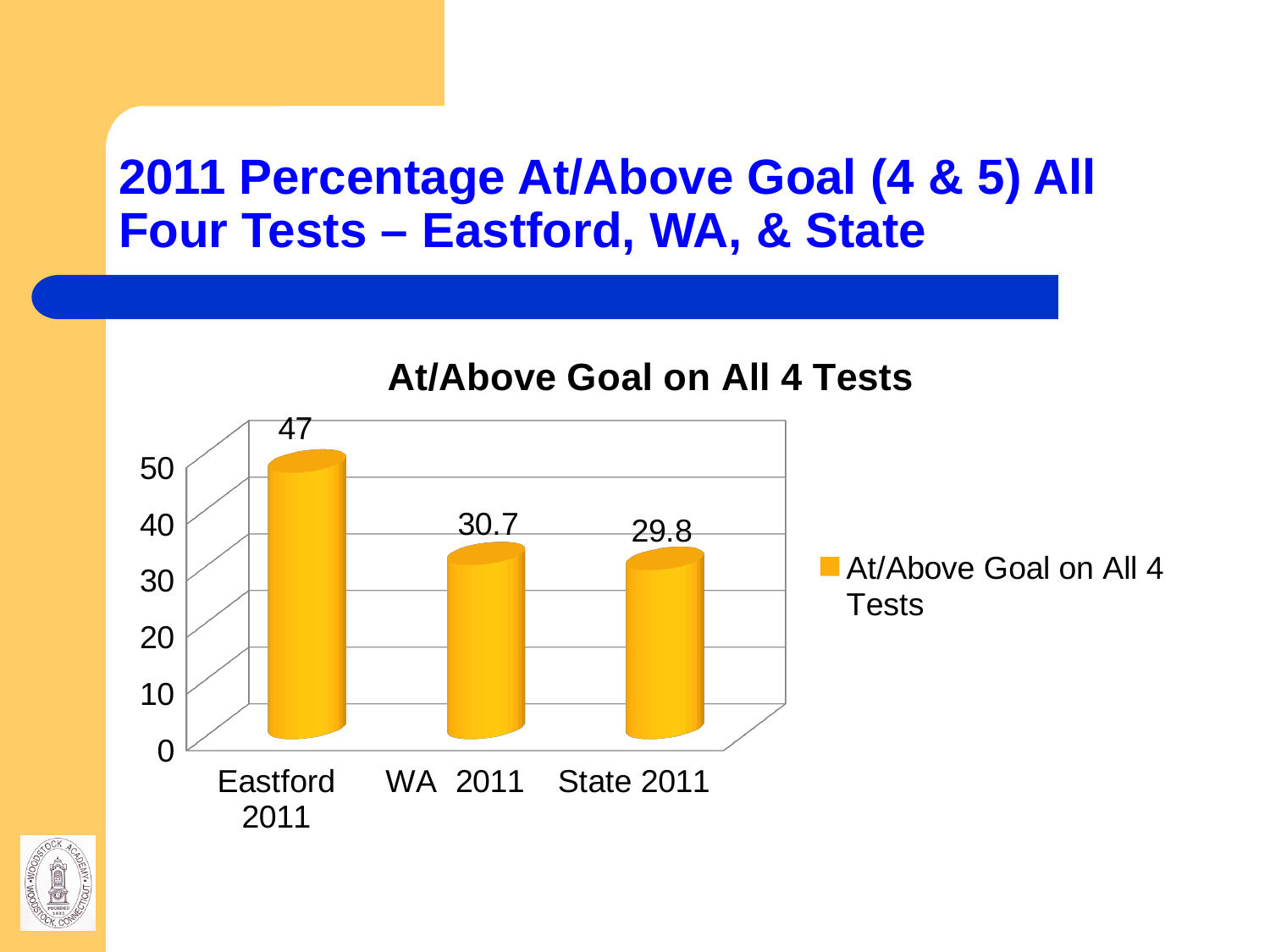
Is the value for Eastford 2011 greater or less than 40? greater How many categories are shown on the x axis? 3 What is the value for State 2011? 29.8 Which category has the lowest value? State 2011 What is the title of the chart? At/Above Goal on All 4 Tests What is the value for Eastford 2011? 47 Which category has the highest value? Eastford 2011 What kind of chart is shown? bar chart What is the difference between the values for WA 2011 and State 2011? 0.9 Which is larger, the value for Eastford 2011 or the value for State 2011? Eastford 2011 What is the value for WA 2011? 30.7 What is the difference between the values for Eastford 2011 and WA 2011? 16.3